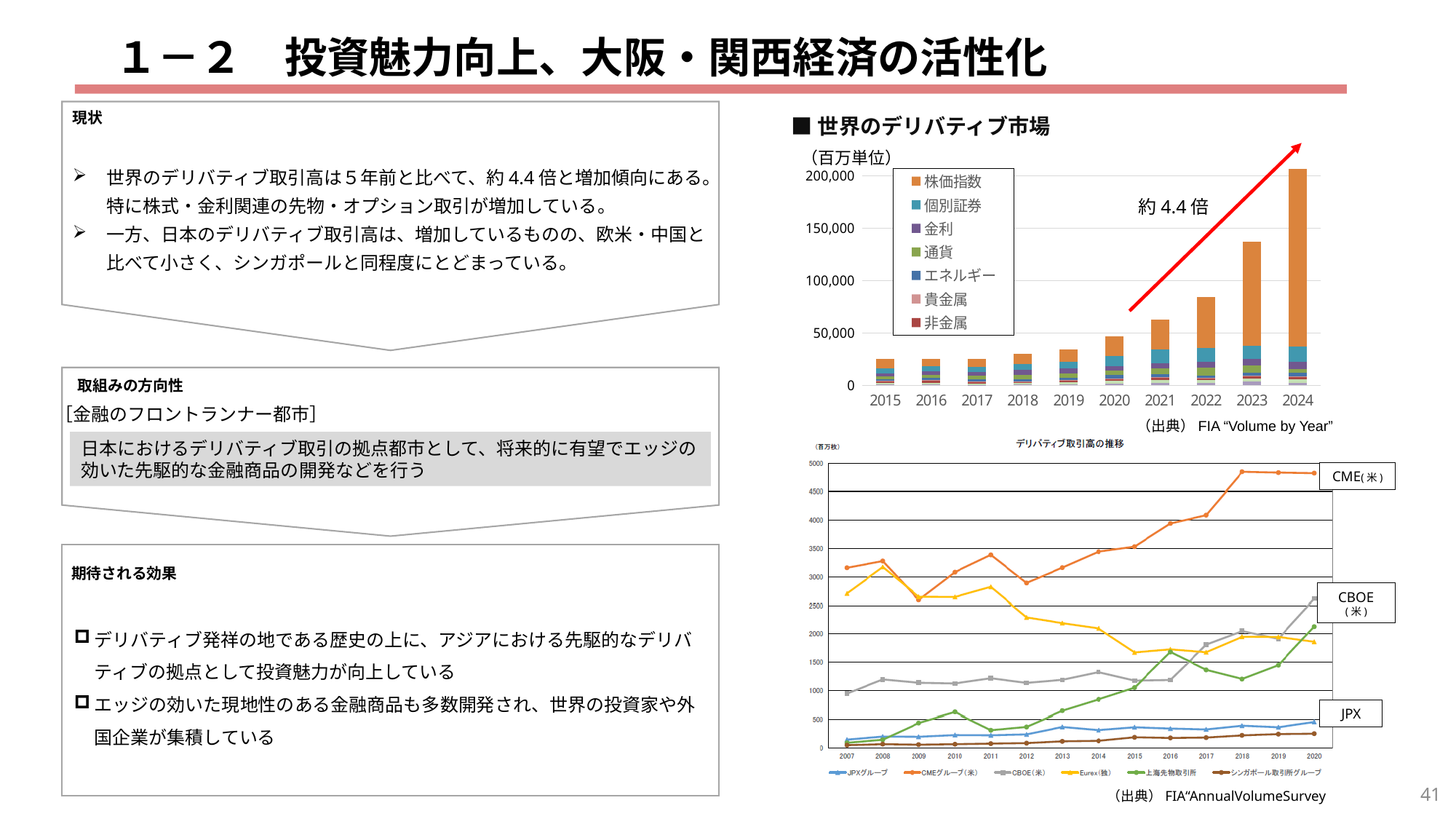
In the bottom chart (デリバティブ取引高の推移), how many years are shown on the x axis? 14 In the top chart (世界のデリバティブ市場), do the bar totals rise or fall from 2015 to 2024? Rise In the bottom chart (デリバティブ取引高の推移), how many series does the legend list? 6 In the top chart (世界のデリバティブ市場), what multiple is written next to the red arrow? 約4.4倍 In the top chart (世界のデリバティブ市場), what kind of chart is used? Stacked bar chart In the top chart (世界のデリバティブ市場), how many years are shown on the x axis? 10 In the bottom chart (デリバティブ取引高の推移), what kind of chart is used? Line chart In the bottom chart (デリバティブ取引高の推移), is the value for CMEグループ(米) in 2018 greater or less than 4500? greater In the top chart (世界のデリバティブ市場), which year has the tallest bar? 2024 In the top chart (世界のデリバティブ市場), how many series does the legend list? 7 In the bottom chart (デリバティブ取引高の推移), which series has the highest value in 2020? CMEグループ(米) In the top chart (世界のデリバティブ市場), is the total for 2023 greater or less than 100,000? greater